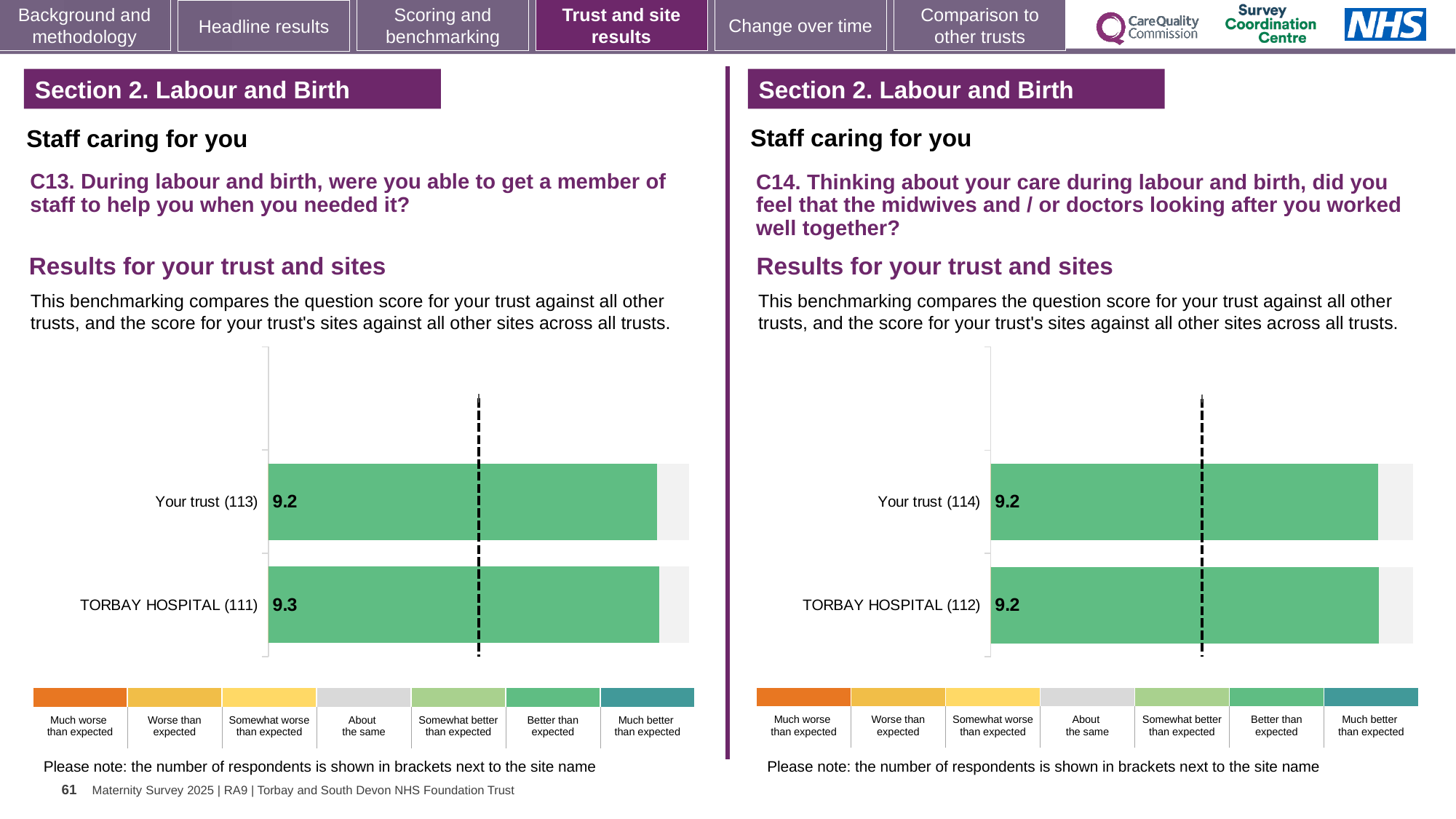
How many bars are plotted in the C14 chart on the right? 2 In the C13 chart on the left, which has the higher score, Your trust or TORBAY HOSPITAL? TORBAY HOSPITAL What kind of chart is used in the C13 chart on the left? Bar chart In the C13 chart on the left, what is the score for Your trust? 9.2 In the C13 chart on the left, what is the score for TORBAY HOSPITAL? 9.3 In the C13 chart on the left, what is the difference between the TORBAY HOSPITAL score and the Your trust score? 0.1 In the C14 chart on the right, what is the score for Your trust? 9.2 In the C14 chart on the right, what is the difference between the Your trust score and the TORBAY HOSPITAL score? 0 In the C14 chart on the right, how many respondents are shown in brackets for Your trust? 114 In the C13 chart on the left, how many respondents are shown in brackets for TORBAY HOSPITAL? 111 In the C14 chart on the right, what is the score for TORBAY HOSPITAL? 9.2 How many bars are plotted in the C13 chart on the left? 2